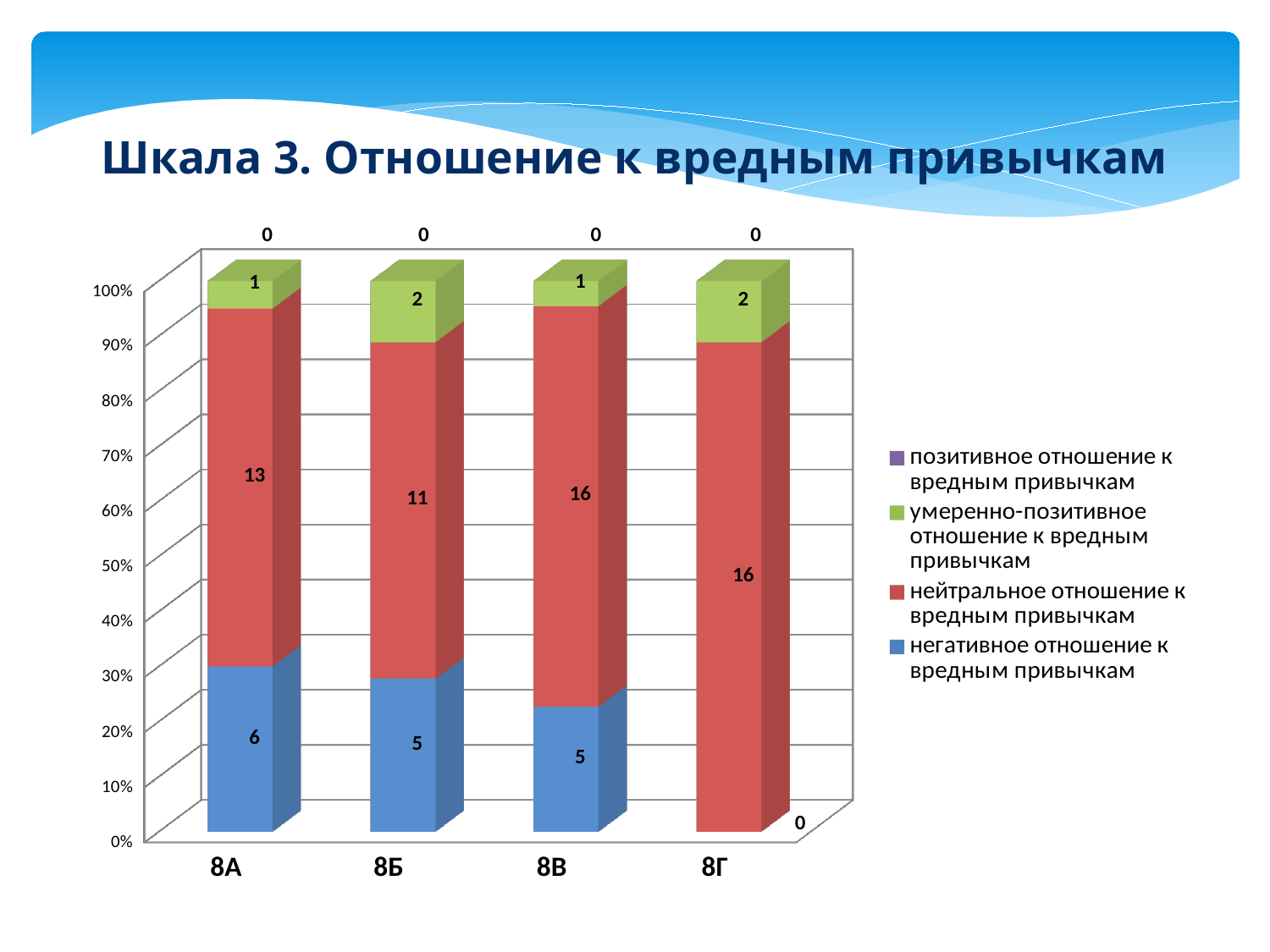
Which class has the highest value for 'негативное отношение к вредным привычкам'? 8А What is the value for 'позитивное отношение к вредным привычкам' in class 8В? 0 How many categories (classes) are shown on the x axis? 4 How many series does the legend list? 4 What is the value for 'негативное отношение к вредным привычкам' in class 8Б? 5 What is the value for 'нейтральное отношение к вредным привычкам' in class 8А? 13 What is the total number of students in the stacked bar for class 8А? 20 What is the difference between the 'нейтральное отношение' values for 8В and 8Б? 5 Which class has the lowest value for 'нейтральное отношение к вредным привычкам'? 8Б What is the value for 'умеренно-позитивное отношение к вредным привычкам' in class 8Г? 2 What kind of chart is shown on the slide? stacked bar chart What is the title of the chart on the slide? Шкала 3. Отношение к вредным привычкам